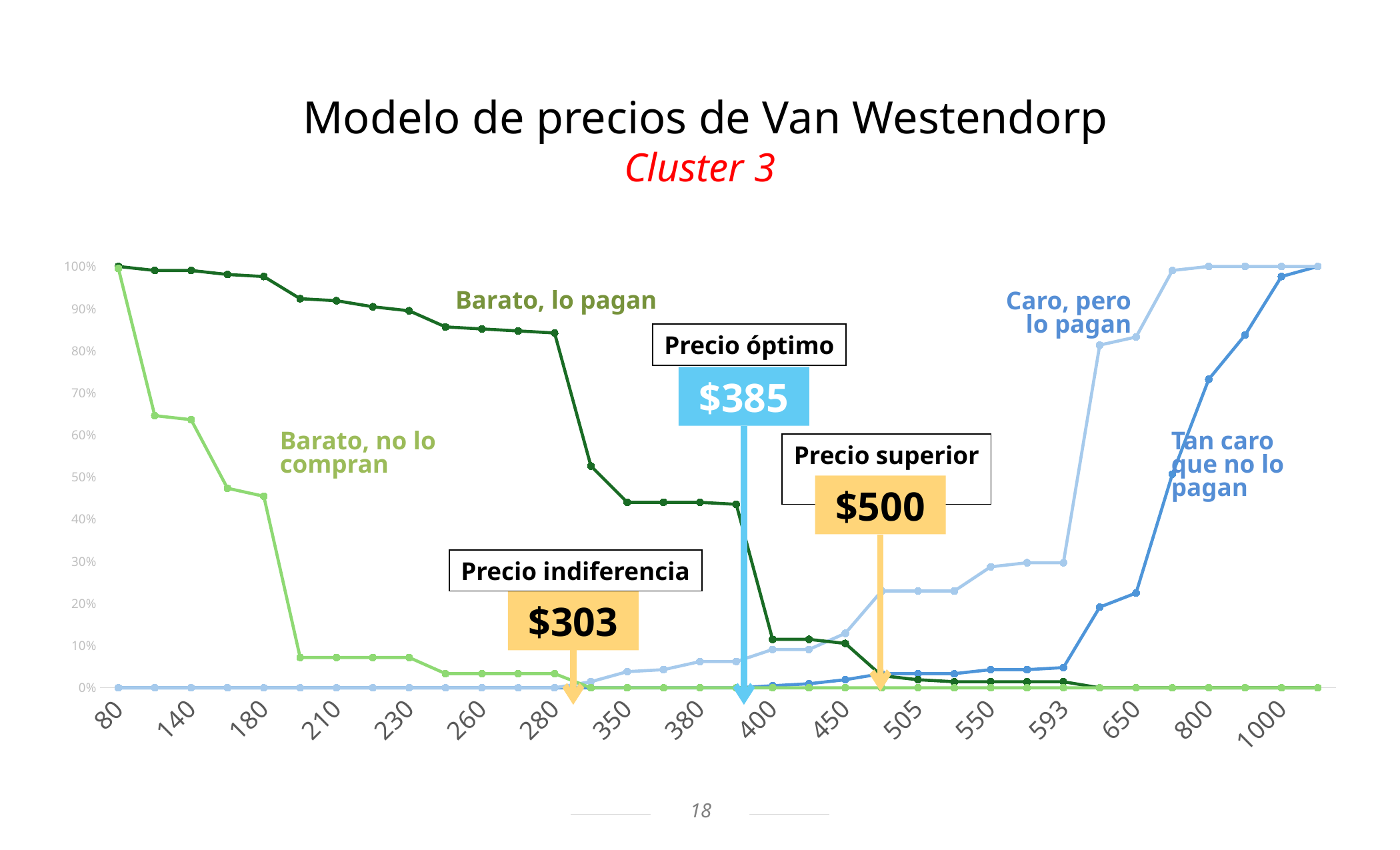
What value is given for the 'Precio óptimo' annotation? $385 What value is given for the 'Precio indiferencia' annotation? $303 Which is larger, the 'Precio óptimo' or the 'Precio superior'? Precio superior What kind of chart is shown on the slide? line chart Is the value of 'Barato, lo pagan' at price 80 greater or less than 90%? greater How many data series are plotted on the chart? 4 What is the title of the chart on the slide? Modelo de precios de Van Westendorp Is the value of 'Tan caro que no lo pagan' at price 80 greater or less than 10%? less What value is given for the 'Precio superior' annotation? $500 What is the difference between the 'Precio superior' and the 'Precio indiferencia' values? $197 Does the 'Tan caro que no lo pagan' line rise or fall as the price increases along the x axis? rise Does the 'Barato, lo pagan' line rise or fall as the price increases along the x axis? fall